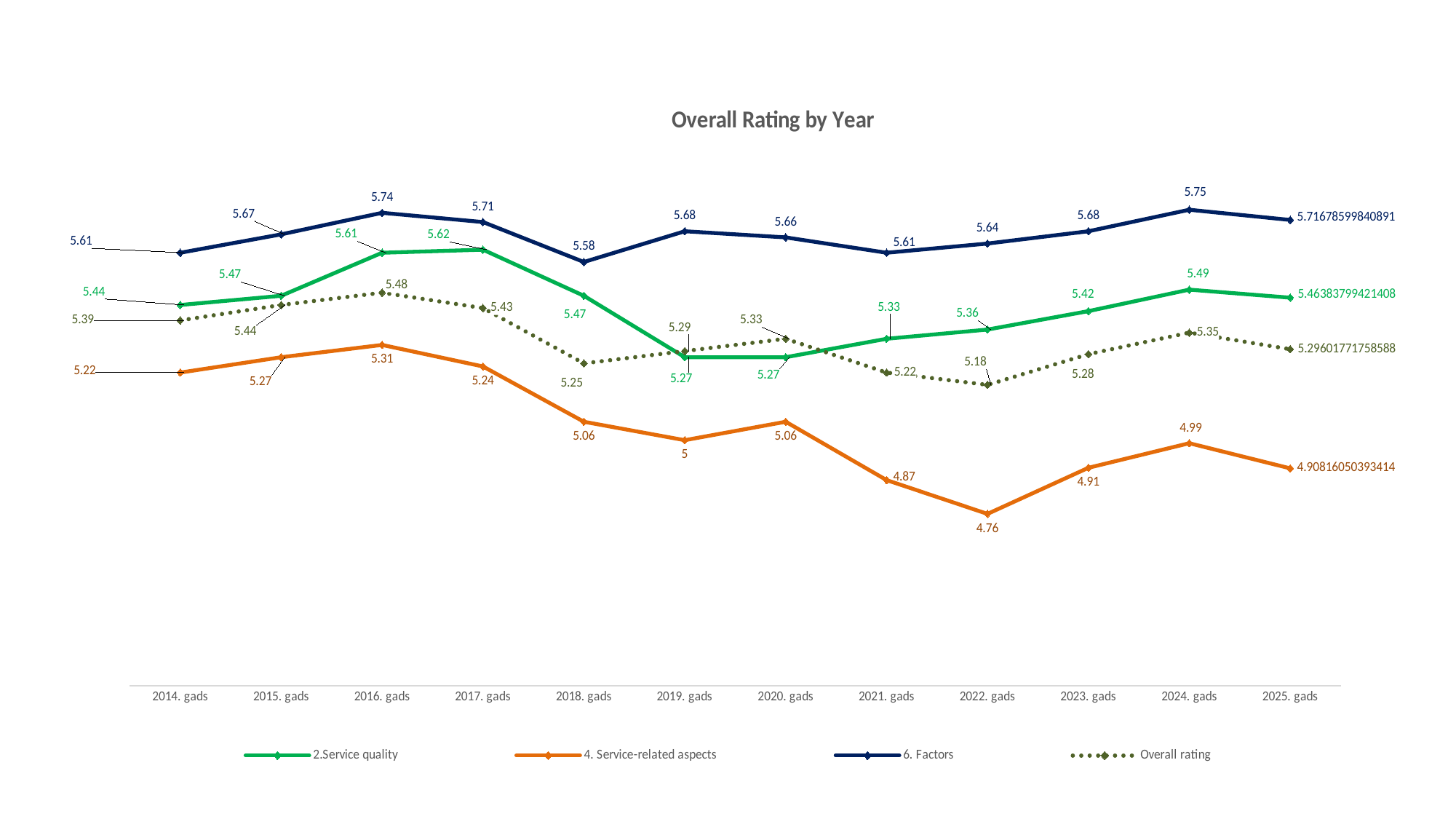
What is the value for 4. Service-related aspects in 2022. gads? 4.76 What is the value for Overall rating in 2022. gads? 5.18 In 2017. gads, which is larger: 2.Service quality or Overall rating? 2.Service quality What is the title of the chart? Overall Rating by Year What is the difference between 6. Factors and 4. Service-related aspects in 2024. gads? 0.76 How many series does the legend list? 4 What type of chart is shown on the slide? line chart In which year does 6. Factors reach its highest value? 2024. gads What is the value for 6. Factors in 2016. gads? 5.74 In which year does 4. Service-related aspects reach its lowest value? 2022. gads How many years are shown on the x axis? 12 Does the 4. Service-related aspects line rise or fall from 2016. gads to 2019. gads? fall